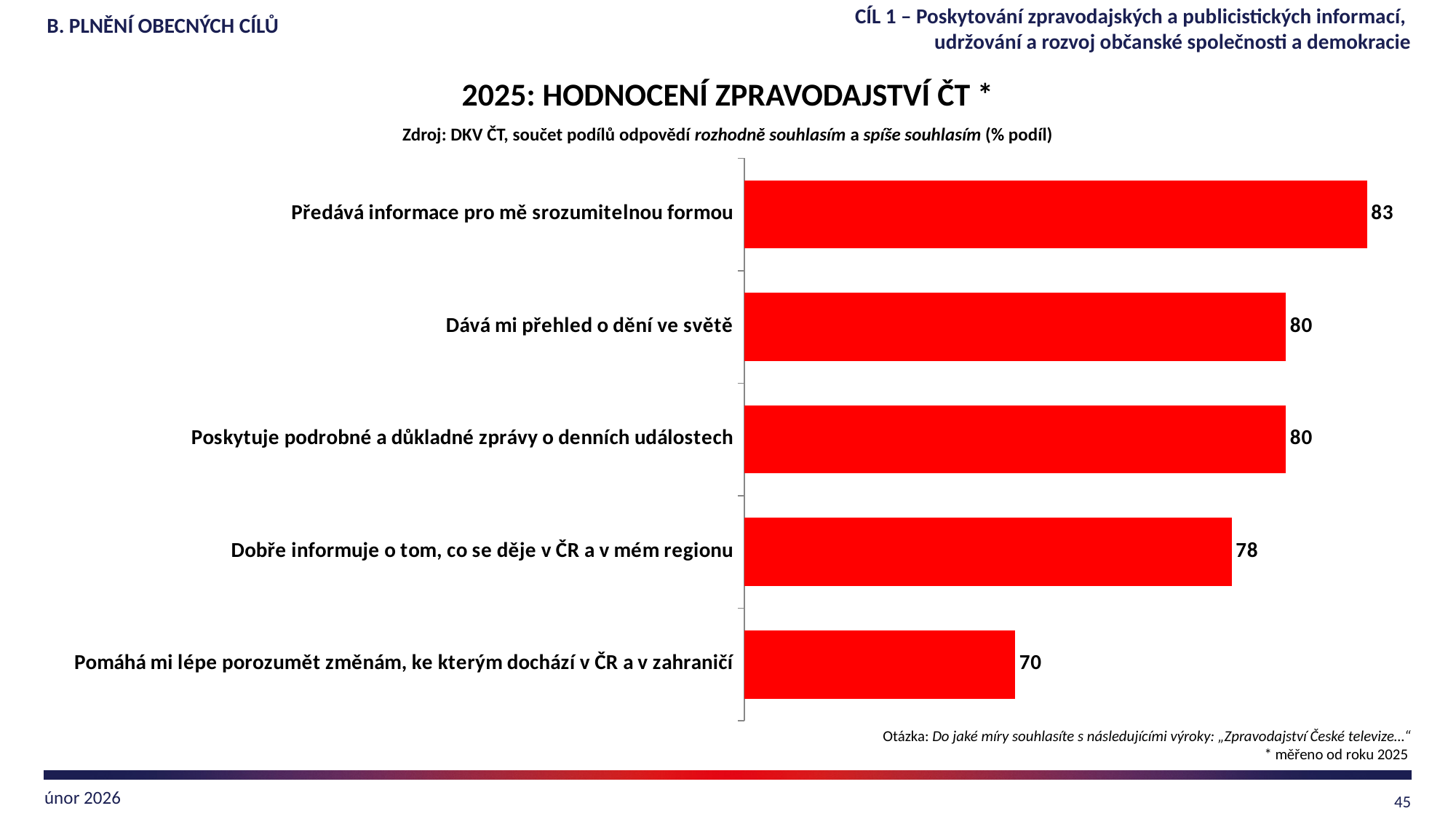
What is the value for "Pomáhá mi lépe porozumět změnám, ke kterým dochází v ČR a v zahraničí"? 70 What is the value for "Dobře informuje o tom, co se děje v ČR a v mém regionu"? 78 What is the title of the chart? 2025: HODNOCENÍ ZPRAVODAJSTVÍ ČT * Which statement has the lowest value? Pomáhá mi lépe porozumět změnám, ke kterým dochází v ČR a v zahraničí What is the value for "Předává informace pro mě srozumitelnou formou"? 83 Which statement has the highest value? Předává informace pro mě srozumitelnou formou What is the difference between the values for "Dobře informuje o tom, co se děje v ČR a v mém regionu" and "Pomáhá mi lépe porozumět změnám, ke kterým dochází v ČR a v zahraničí"? 8 How many statements are shown in the chart? 5 What is the value for "Dává mi přehled o dění ve světě"? 80 What kind of chart is shown on the slide? Bar chart What is the difference between the values for "Předává informace pro mě srozumitelnou formou" and "Pomáhá mi lépe porozumět změnám, ke kterým dochází v ČR a v zahraničí"? 13 Which is larger: the value for "Předává informace pro mě srozumitelnou formou" or for "Dobře informuje o tom, co se děje v ČR a v mém regionu"? Předává informace pro mě srozumitelnou formou